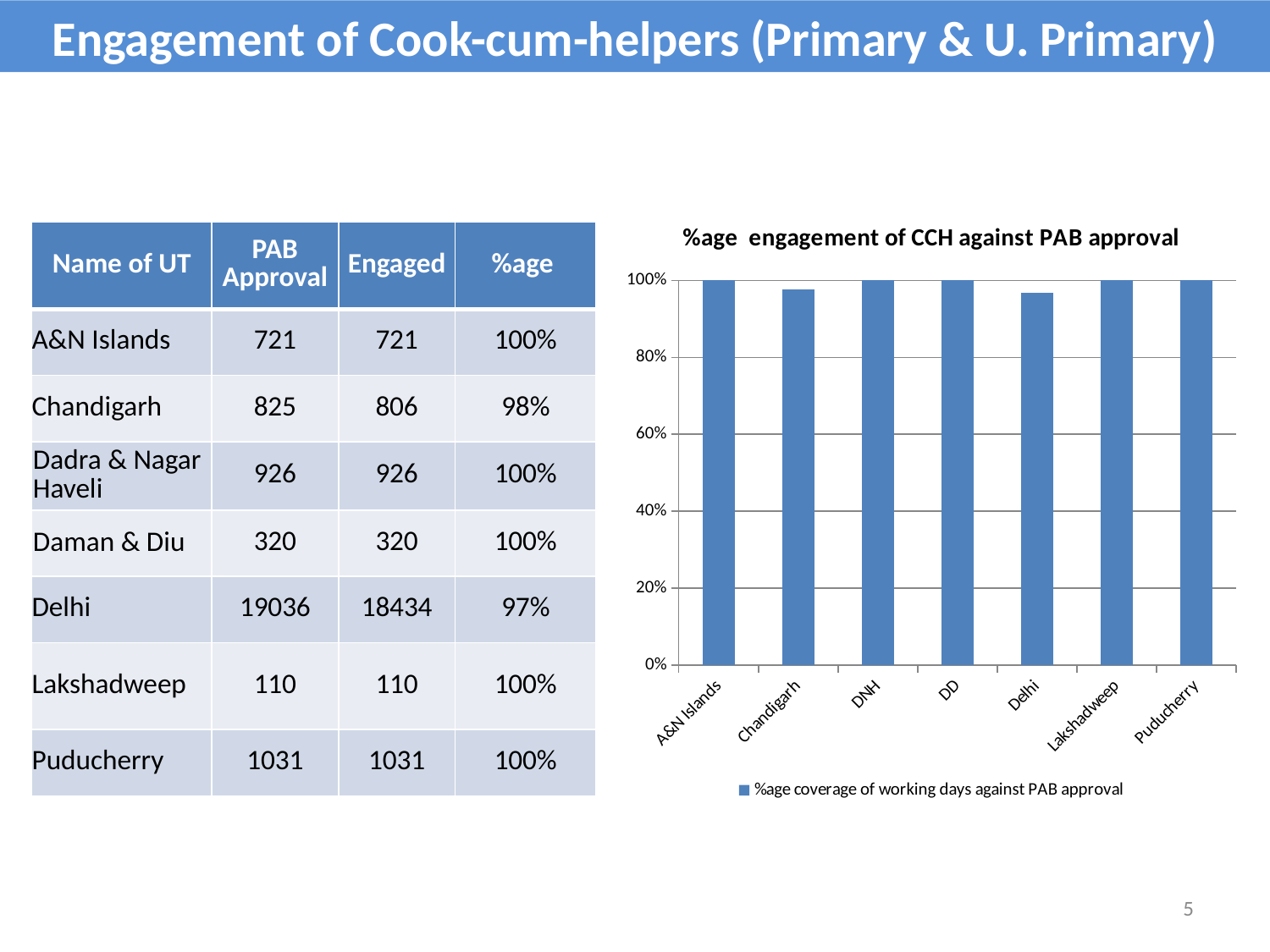
What is the value for A&N Islands in the chart? 100% How many UTs are plotted on the x axis of the chart? 7 What is the legend entry shown below the chart? %age coverage of working days against PAB approval What kind of chart is shown on the slide? bar chart Which UT has the lowest value in the chart? Delhi What is the title of the chart? %age engagement of CCH against PAB approval Is the value for Chandigarh greater or less than 80%? greater Is the value for Delhi greater or less than 60%? greater How many series does the chart legend list? 1 What is the value for Puducherry in the chart? 100% Which is larger, the value for DNH or the value for Delhi? DNH